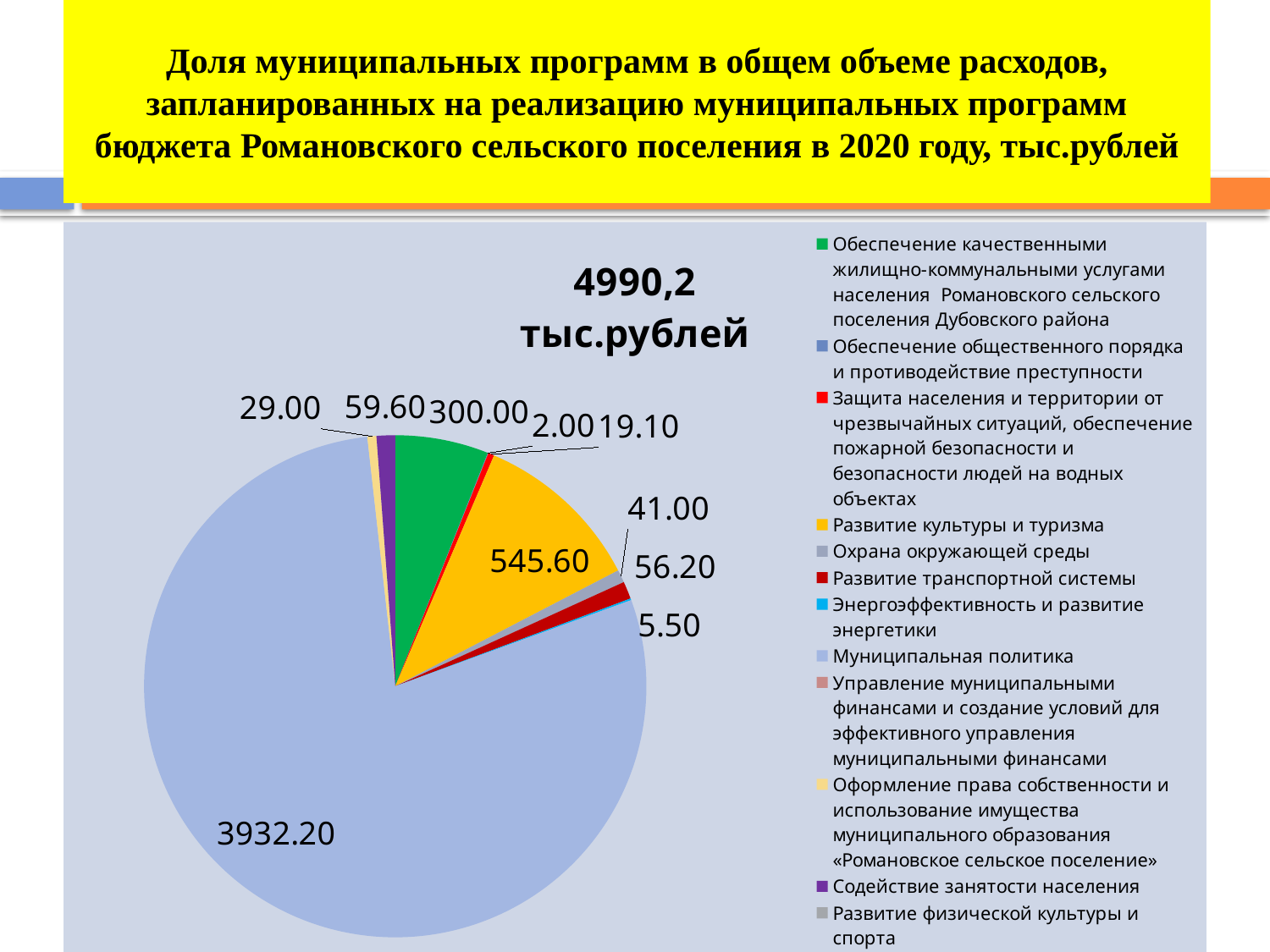
Which is larger: Развитие культуры и туризма (yellow) or Обеспечение качественными жилищно-коммунальными услугами (green)? Развитие культуры и туризма What total value is printed above the pie chart? 4990,2 тыс.рублей What is the value of the largest slice of the pie? 3932.20 How many entries does the legend list? 12 How many data labels are printed on the pie chart? 10 What kind of chart is shown on the slide? pie chart What is the smallest value labelled on the pie chart? 2.00 What is the value of the yellow slice (Развитие культуры и туризма)? 545.60 What is the difference between the yellow slice (545.60) and the green slice (300.00)? 245.60 Which is larger: the slice labelled 56.20 or the slice labelled 41.00? 56.20 What share of the total 4990,2 does the largest slice (3932.20) represent? 78.8% What is the value of the green slice (Обеспечение качественными жилищно-коммунальными услугами населения)? 300.00